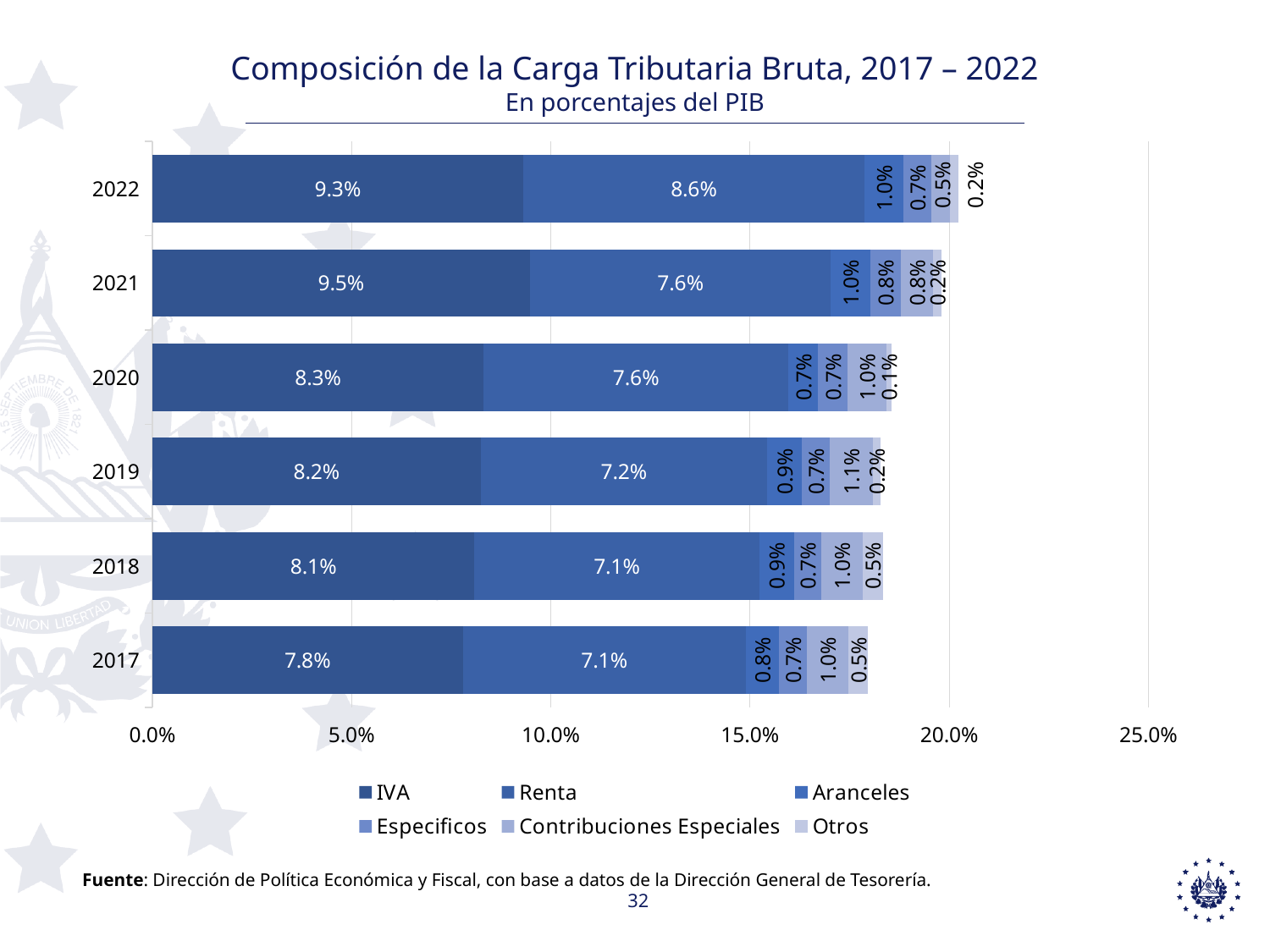
Is the total length of the 2017 bar greater or less than 20.0%? less What is the IVA value for 2022? 9.3% What is the Otros value for 2018? 0.5% What is the total of the stacked bar for 2022? 20.3% What kind of chart is shown on the slide? Stacked bar chart How many series does the legend list? 6 Which is larger, the Renta value for 2022 or for 2021? 2022 How many years are shown on the chart? 6 What is the Renta value for 2021? 7.6% In which year is the IVA value highest? 2021 What is the difference between the IVA value in 2022 and in 2017? 1.5% In which year is the IVA value lowest? 2017